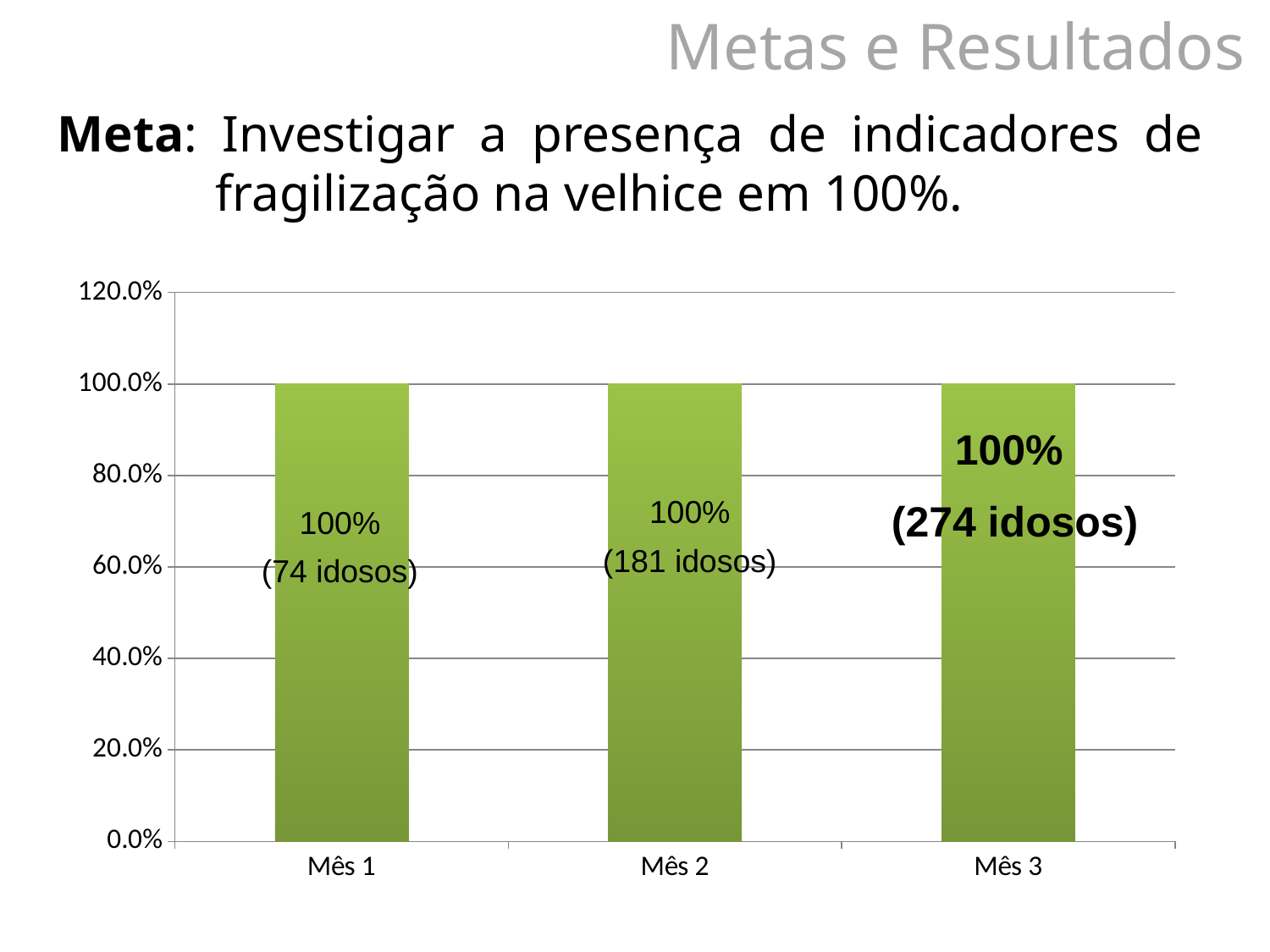
Is the value for Mês 2 greater or less than 80.0%? greater How many idosos are indicated in the data label for Mês 2? 181 idosos What percentage value is shown for Mês 1? 100% What kind of chart is shown on the slide? Bar chart Do the percentage values rise, fall, or stay the same from Mês 1 to Mês 3? Stay the same What is the highest value shown on the y axis of the chart? 120.0% How many idosos are indicated in the data label for Mês 3? 274 idosos What percentage value is shown for Mês 3? 100% Which month has the largest number of idosos in its data label? Mês 3 How many categories are shown on the x axis of the chart? 3 What is the difference in the number of idosos between Mês 3 and Mês 2? 93 What is the difference between the percentage values for Mês 1 and Mês 3? 0%